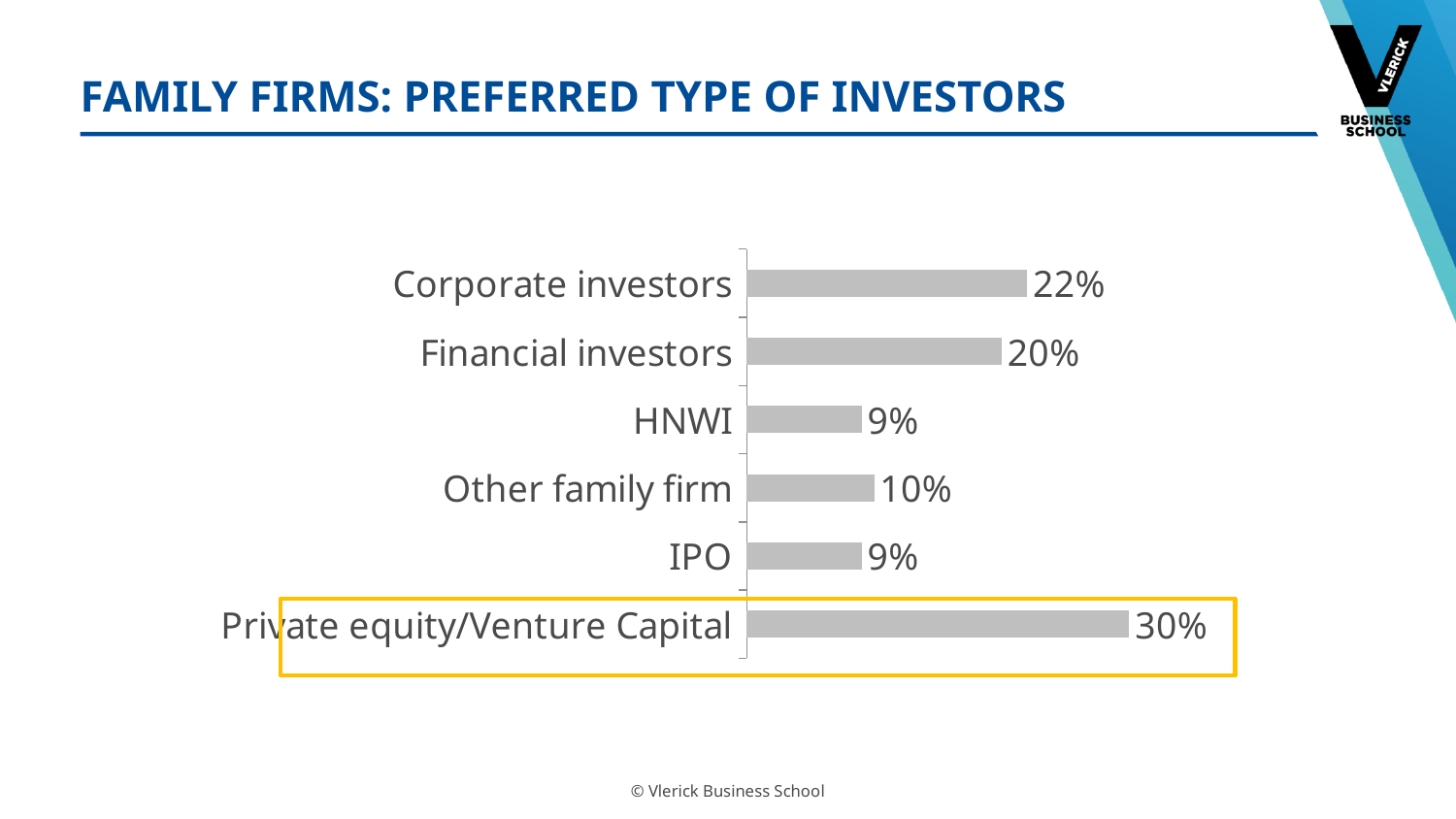
What is the difference between the values for Private equity/Venture Capital and Corporate investors? 8% What is the difference between the values for Corporate investors and Financial investors? 2% What is the value for Corporate investors? 22% How many categories are shown in the chart? 6 What kind of chart is shown on the slide? Bar chart Which is larger, the value for Other family firm or the value for IPO? Other family firm What is the value for Financial investors? 20% What is the value for Other family firm? 10% Which category has the highest value? Private equity/Venture Capital What is the value for Private equity/Venture Capital? 30% What is the value for HNWI? 9% Which category is highlighted with a yellow box? Private equity/Venture Capital